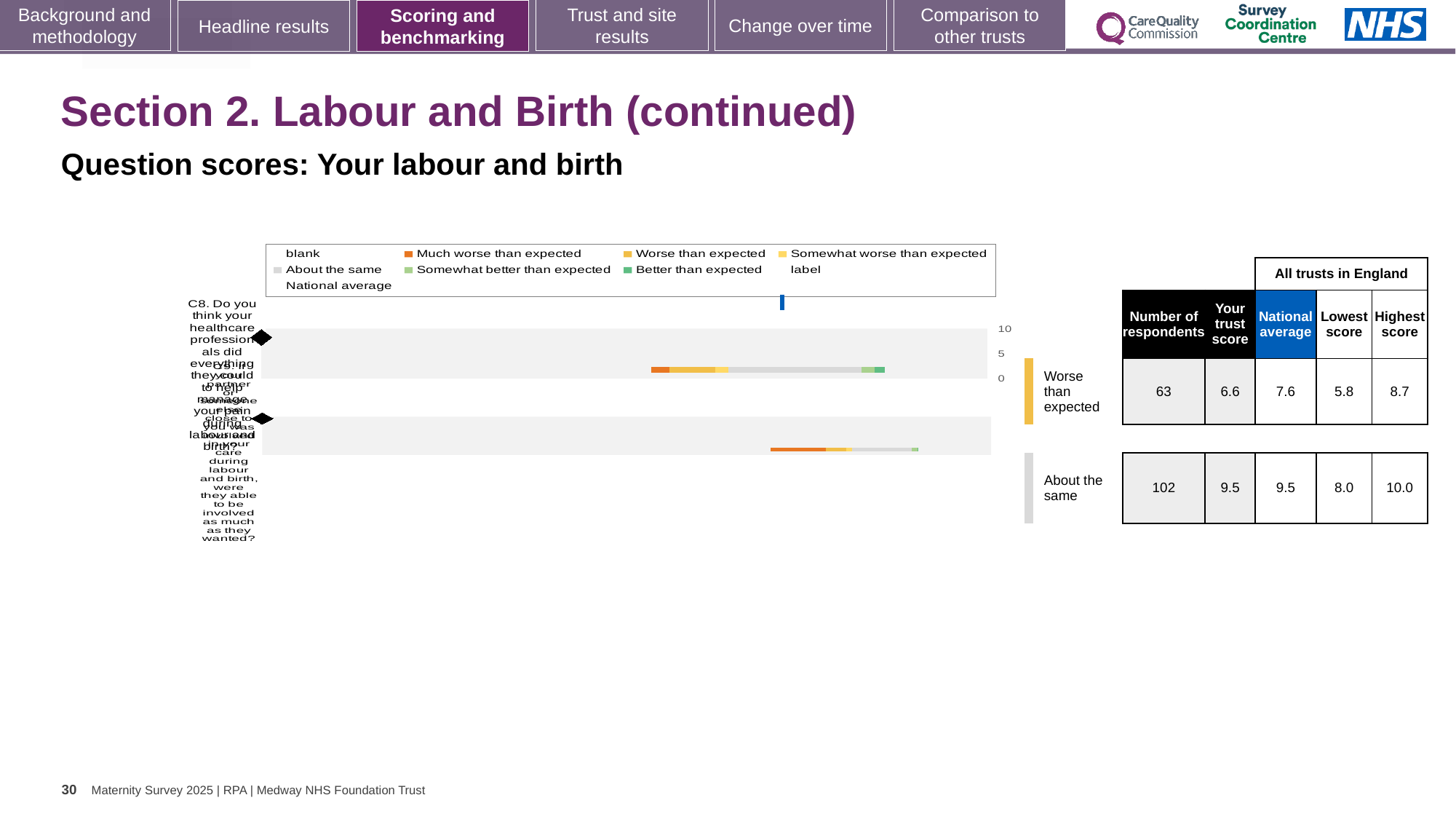
What is the trust score for the question rated 'Worse than expected'? 6.6 What is the number of respondents for the question rated 'Worse than expected'? 63 What is the lowest score among all trusts in England for the question rated 'Worse than expected'? 5.8 What is the trust score for the question rated 'About the same'? 9.5 How many question rows (bars) are plotted in the chart? 2 What is the national average for the question rated 'Worse than expected'? 7.6 What is the maximum value shown on the chart's score axis? 10 What kind of chart is shown on the slide? bar chart What is the highest score among all trusts in England for the question rated 'About the same'? 10.0 What is the difference between the national average and the trust score for the question rated 'Worse than expected'? 1.0 What is the number of respondents for the question rated 'About the same'? 102 Which question has the higher trust score: the one rated 'Worse than expected' or the one rated 'About the same'? About the same